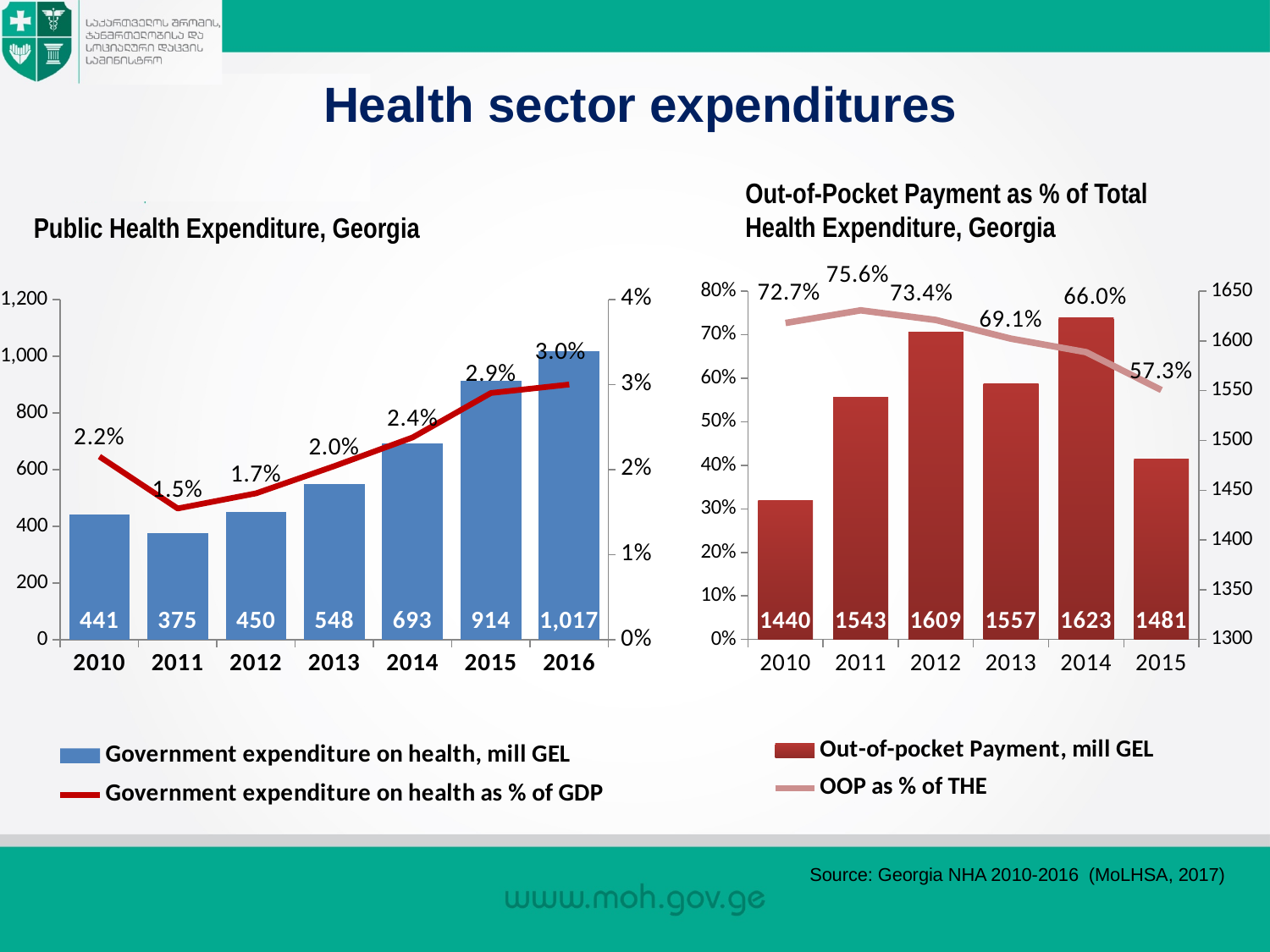
In the 'Out-of-Pocket Payment as % of Total Health Expenditure, Georgia' chart, which year has the highest OOP as % of THE? 2011 In the 'Out-of-Pocket Payment as % of Total Health Expenditure, Georgia' chart, which year has the highest out-of-pocket payment in mill GEL? 2014 In the 'Public Health Expenditure, Georgia' chart, does government expenditure on health as % of GDP rise or fall from 2011 to 2016? rise How many series does the legend of the 'Out-of-Pocket Payment as % of Total Health Expenditure, Georgia' chart list? 2 In the 'Out-of-Pocket Payment as % of Total Health Expenditure, Georgia' chart, what was OOP as % of THE in 2015? 57.3% In the 'Public Health Expenditure, Georgia' chart, what was government expenditure on health as % of GDP in 2011? 1.5% In the 'Public Health Expenditure, Georgia' chart, how many years are shown on the x axis? 7 In the 'Out-of-Pocket Payment as % of Total Health Expenditure, Georgia' chart, is the out-of-pocket payment in mill GEL larger in 2013 or in 2011? 2013 In the 'Out-of-Pocket Payment as % of Total Health Expenditure, Georgia' chart, what was the out-of-pocket payment in mill GEL in 2012? 1609 In the 'Public Health Expenditure, Georgia' chart, which year has the lowest government expenditure on health in mill GEL? 2011 In the 'Public Health Expenditure, Georgia' chart, what is the difference in government expenditure on health (mill GEL) between 2016 and 2015? 103 In the 'Public Health Expenditure, Georgia' chart, what was government expenditure on health in mill GEL in 2014? 693